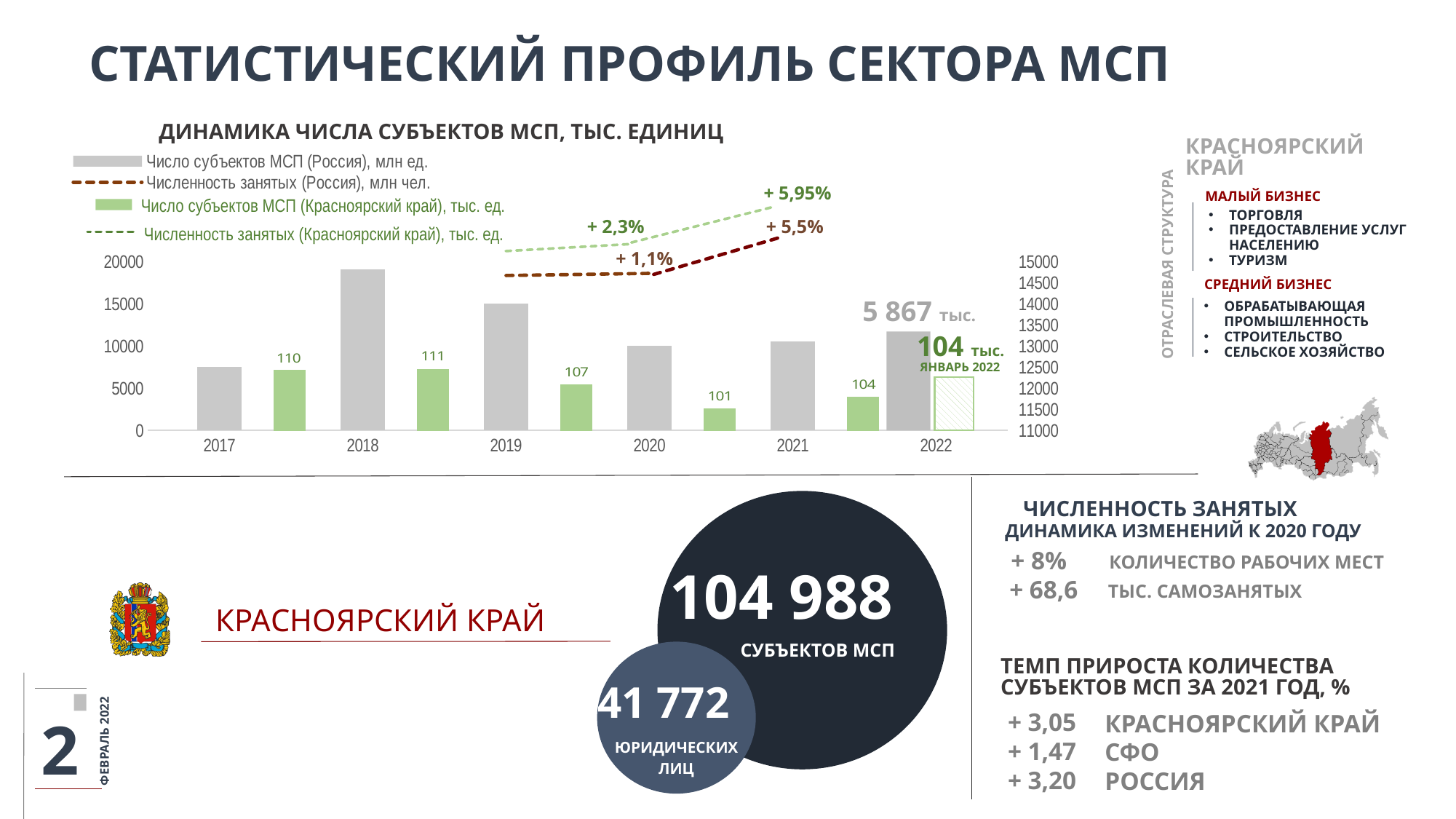
In the chart 'ДИНАМИКА ЧИСЛА СУБЪЕКТОВ МСП, ТЫС. ЕДИНИЦ', which green bar is larger, 2019 or 2021? 2019 Do the green bar values in the chart 'ДИНАМИКА ЧИСЛА СУБЪЕКТОВ МСП, ТЫС. ЕДИНИЦ' rise or fall from 2018 to 2020? fall In the chart 'ДИНАМИКА ЧИСЛА СУБЪЕКТОВ МСП, ТЫС. ЕДИНИЦ', which year has the highest value among the green bars (Красноярский край)? 2018 In the chart 'ДИНАМИКА ЧИСЛА СУБЪЕКТОВ МСП, ТЫС. ЕДИНИЦ', what is the value of the green bar for 2020? 101 In the chart 'ДИНАМИКА ЧИСЛА СУБЪЕКТОВ МСП, ТЫС. ЕДИНИЦ', what is the difference between the green bar values for 2018 and 2020? 10 In the chart 'ДИНАМИКА ЧИСЛА СУБЪЕКТОВ МСП, ТЫС. ЕДИНИЦ', what is the value of the green bar (Число субъектов МСП, Красноярский край) for 2018? 111 In the chart 'ДИНАМИКА ЧИСЛА СУБЪЕКТОВ МСП, ТЫС. ЕДИНИЦ', which year has the lowest value among the green bars (Красноярский край)? 2020 How many years are shown on the x axis of the chart 'ДИНАМИКА ЧИСЛА СУБЪЕКТОВ МСП, ТЫС. ЕДИНИЦ'? 6 How many series does the legend of the chart 'ДИНАМИКА ЧИСЛА СУБЪЕКТОВ МСП, ТЫС. ЕДИНИЦ' list? 4